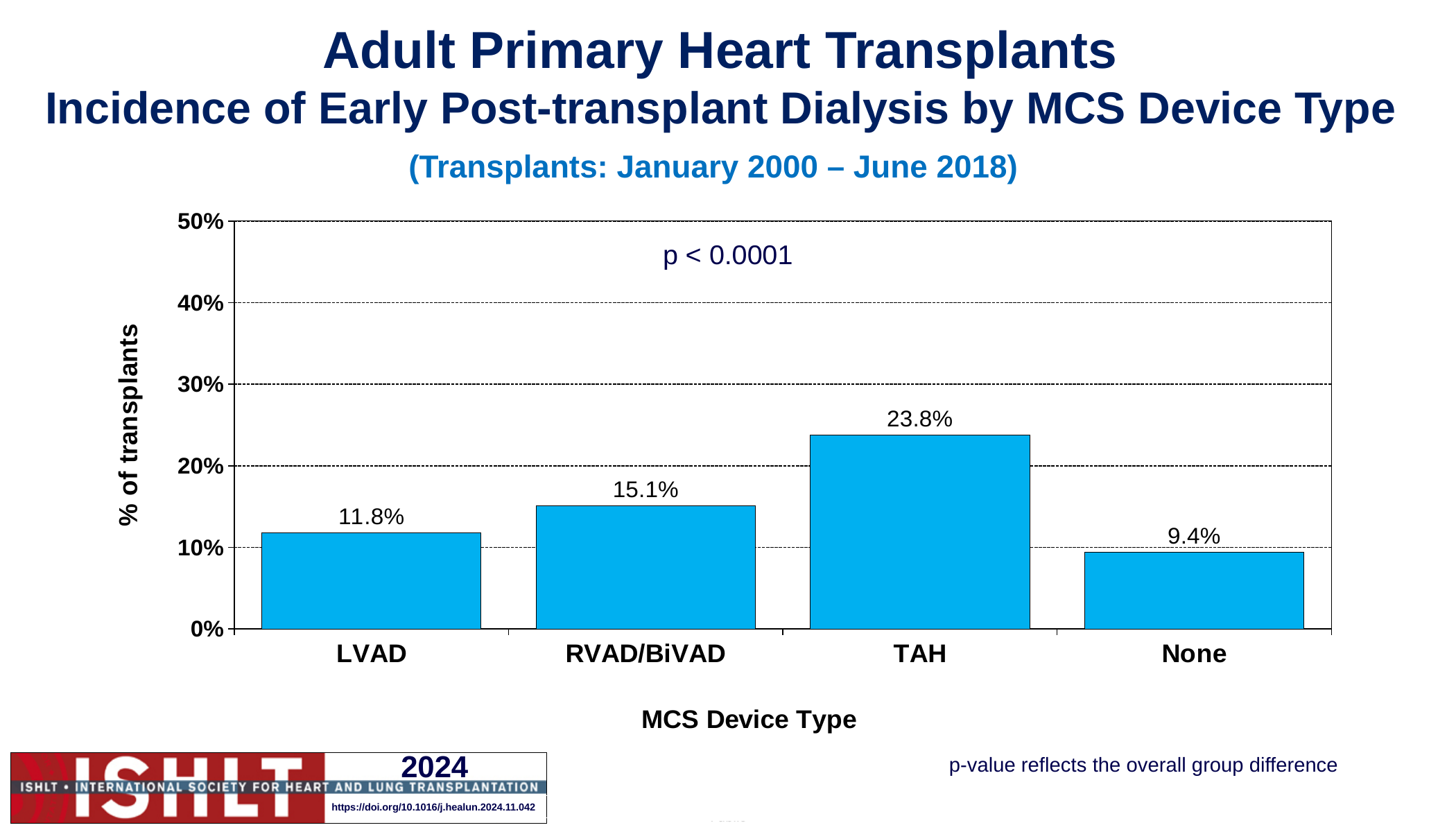
What is the difference between the TAH value and the LVAD value? 12.0% Which is larger, the value for RVAD/BiVAD or the value for LVAD? RVAD/BiVAD What is the incidence of early post-transplant dialysis for LVAD? 11.8% What is the value shown for TAH? 23.8% Which MCS device type has the highest incidence of early post-transplant dialysis? TAH What is the value shown for the None device type? 9.4% How many MCS device type categories are shown on the x axis? 4 What p-value is printed on the chart? p < 0.0001 What is the value shown for RVAD/BiVAD? 15.1% Is the value for TAH greater or less than 20%? greater What kind of chart is shown on the slide? Bar chart Which MCS device type has the lowest incidence of early post-transplant dialysis? None